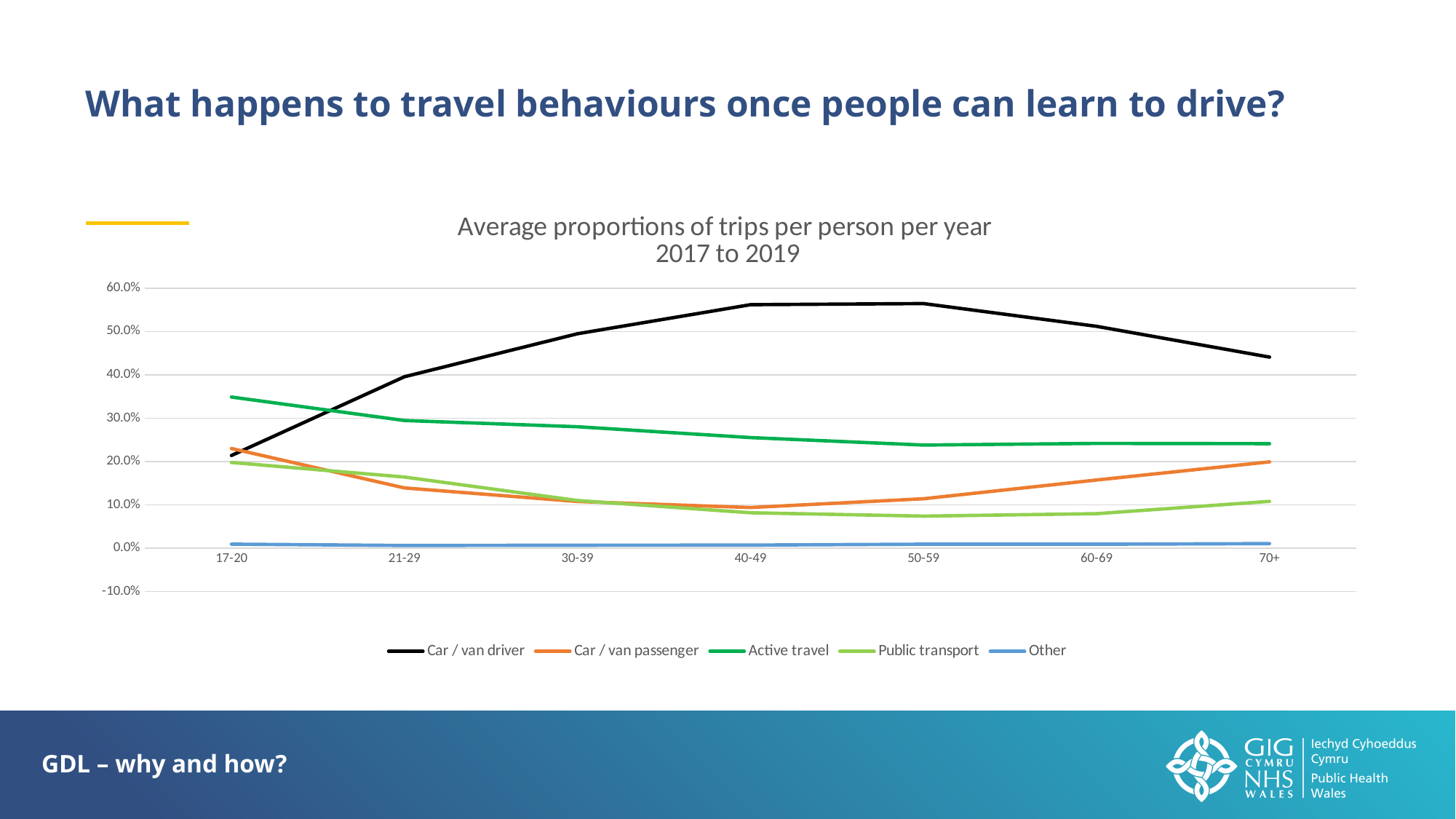
Is the value for Active travel at 17-20 greater or less than 30.0%? greater Which age group has the highest value for Active travel? 17-20 Which age group has the lowest value for Car / van driver? 17-20 What kind of chart is shown on the slide? line chart Which series has the highest value for the 40-49 age group? Car / van driver How many age groups are shown on the x axis? 7 Which series has the lowest values across all age groups? Other Does the Car / van driver line rise or fall from 17-20 to 40-49? rises At 17-20, which is larger: Active travel or Car / van driver? Active travel What is the title of the chart? Average proportions of trips per person per year 2017 to 2019 How many series does the legend list? 5 Is the value for Car / van driver at 40-49 greater or less than 50.0%? greater